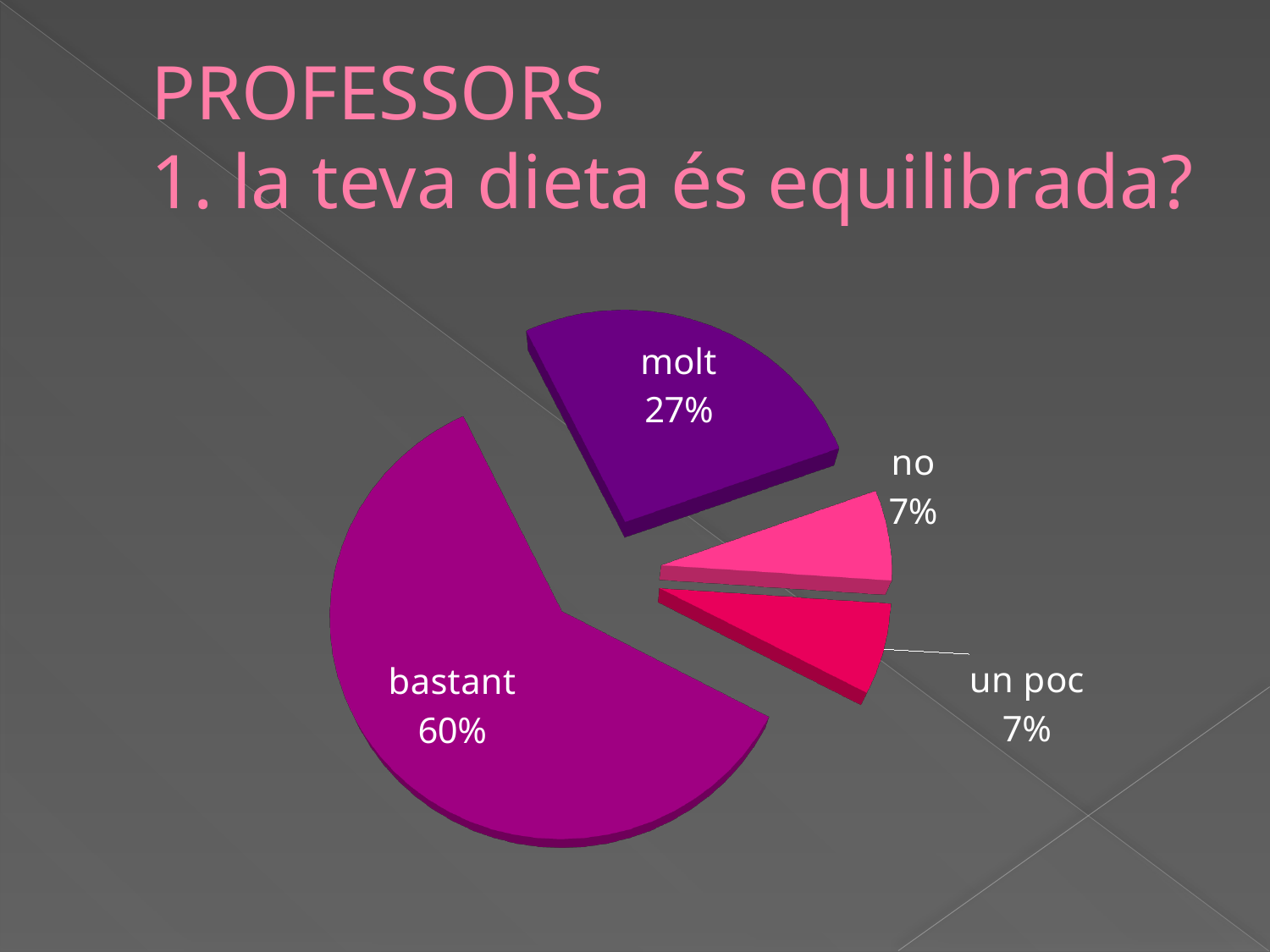
What percentage is shown for the "molt" slice? 27% What percentage is shown for the "un poc" slice? 7% How many slices does the pie chart have? 4 Which category has the largest share of the pie? bastant What percentage is shown for the "bastant" slice? 60% What is the difference in percentage points between the "bastant" and "molt" slices? 33 What question is the chart on the slide about, according to the slide title? 1. la teva dieta és equilibrada? What is the combined share of the "no" and "un poc" slices? 14% Which is larger, the "molt" slice or the "no" slice? molt What kind of chart is shown on the slide? pie chart What percentage is shown for the "no" slice? 7% Is the share for "bastant" greater or less than 50%? greater